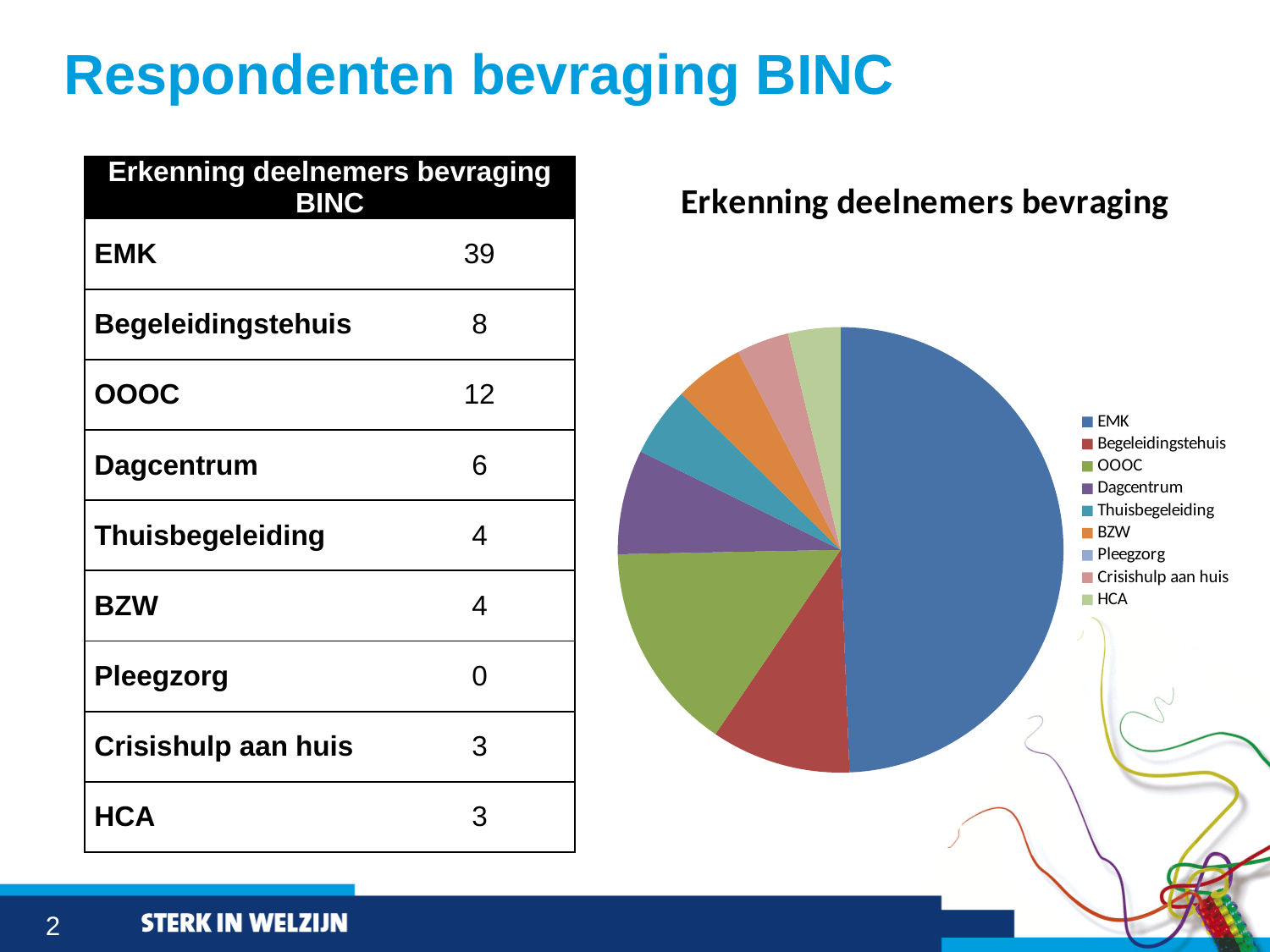
What is the value for Begeleidingstehuis? 8 Which is larger, the value for Begeleidingstehuis or the value for Dagcentrum? Begeleidingstehuis What kind of chart is shown on the slide? pie chart How many categories does the pie chart's legend list? 9 What is the difference between the values for EMK and OOOC? 27 Which category has the smallest value? Pleegzorg What is the title of the pie chart? Erkenning deelnemers bevraging Which category has the largest slice of the pie? EMK What colour is the EMK slice in the pie chart? blue What is the value for EMK? 39 What is the value for OOOC? 12 What is the value for Pleegzorg? 0